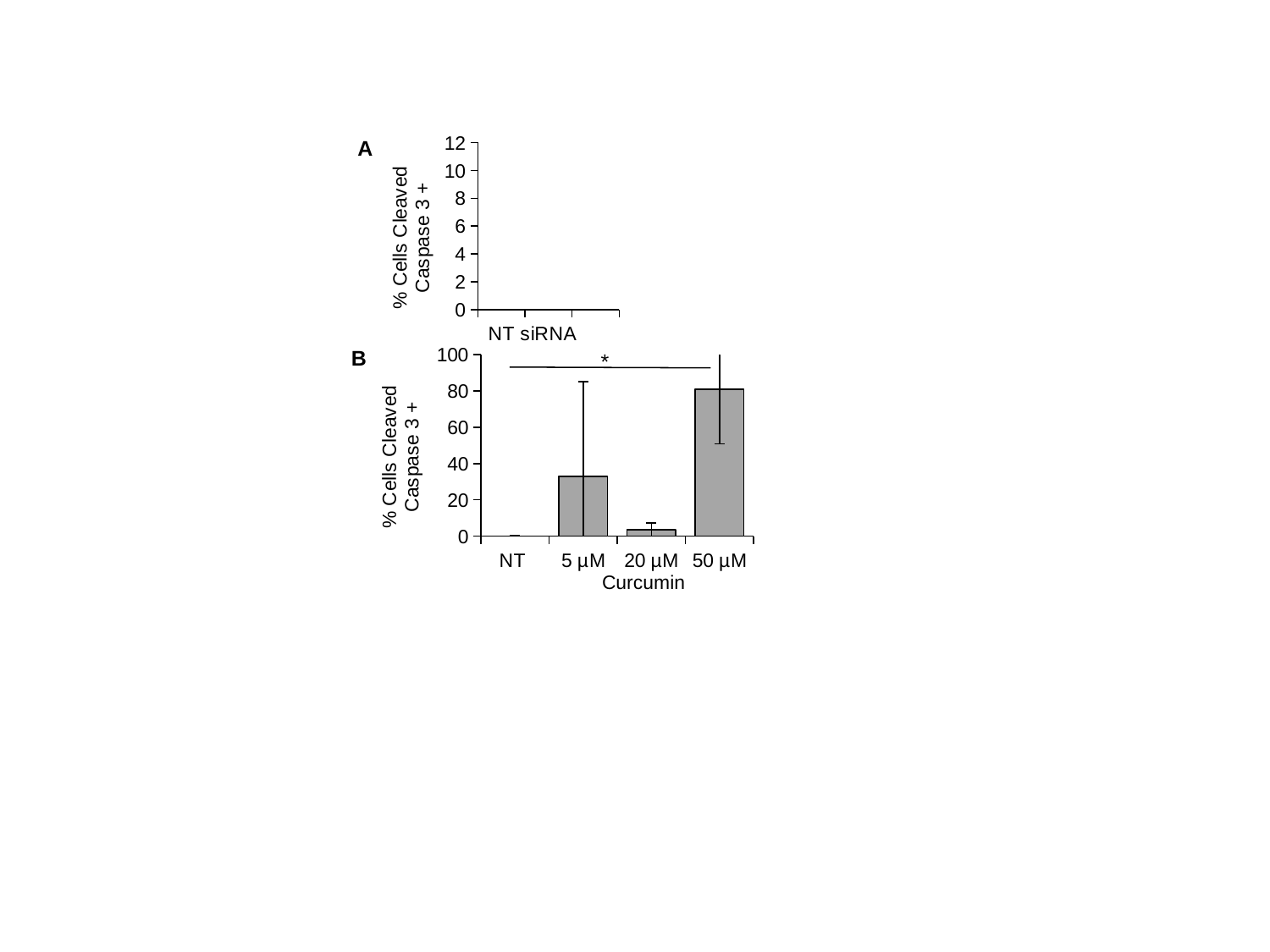
In chart B (the bottom chart), is the value for 50 µM greater or less than 60? greater What is the x-axis title of chart B (the bottom chart)? Curcumin In chart B (the bottom chart), which category has the lowest value? NT In chart B (the bottom chart), is the value for 20 µM greater or less than 20? less In chart B (the bottom chart), which is larger, the value for 5 µM or the value for 20 µM? 5 µM In chart B (the bottom chart), is the value for 5 µM greater or less than 60? less What kind of chart is chart B (the bottom chart)? bar chart How many categories are shown on the x axis of chart B (the bottom chart)? 4 What is the y-axis label of chart B (the bottom chart)? % Cells Cleaved Caspase 3 + In chart B (the bottom chart), which is larger, the value for 50 µM or the value for 5 µM? 50 µM In chart B (the bottom chart), which category has the highest value? 50 µM